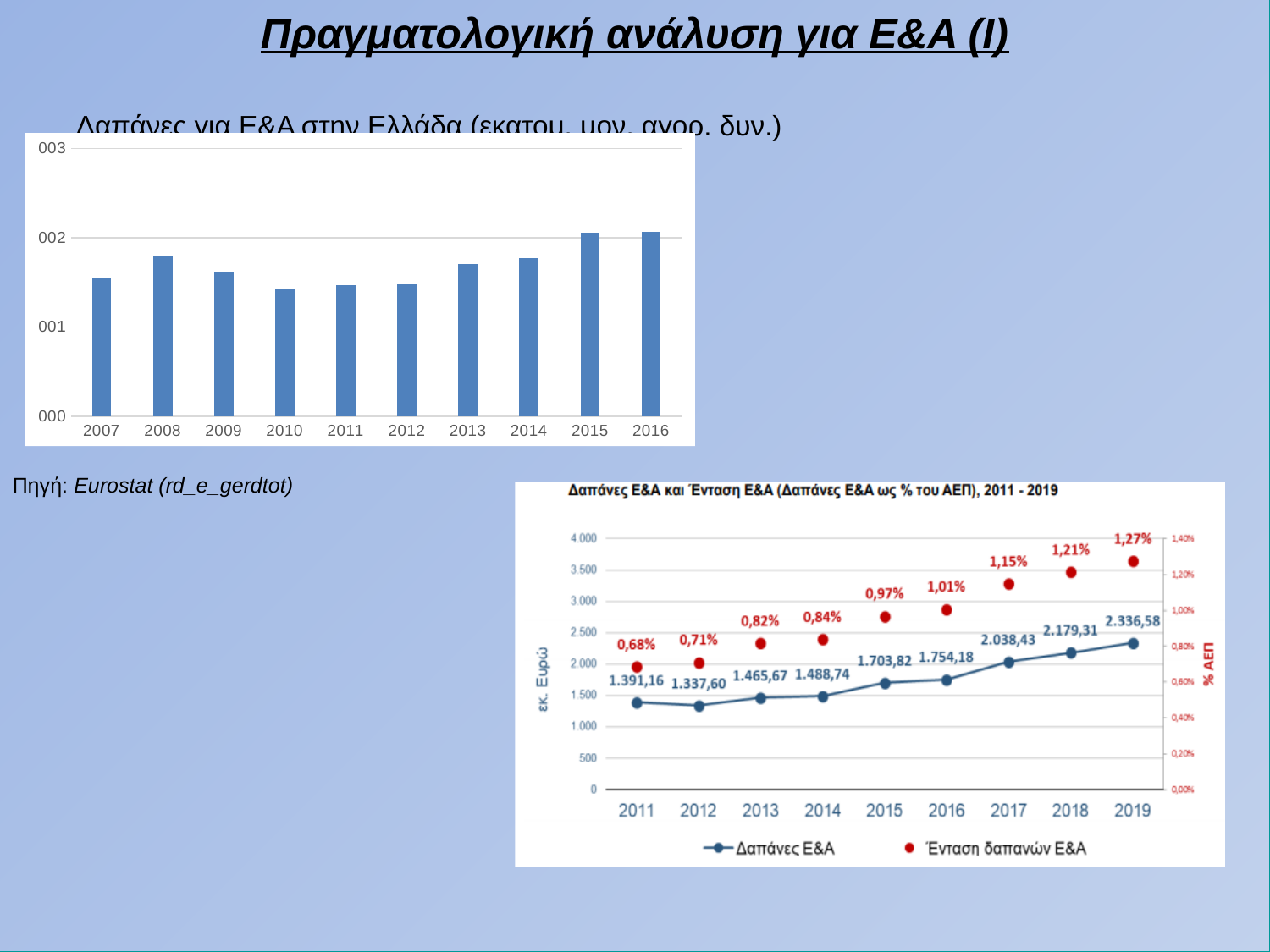
In the bottom-right chart, what is the Ένταση δαπανών Ε&Α value for 2011? 0,68% In the top-left bar chart, is the value for 2010 greater or less than 002? less In the bottom-right chart, which year has the highest Ένταση δαπανών Ε&Α value? 2019 What kind of chart is the top-left chart titled 'Δαπάνες για Ε&Α στην Ελλάδα'? bar chart In the bottom-right chart, which year has the lowest Δαπάνες Ε&Α value? 2012 In the top-left bar chart, how many years are shown on the x axis? 10 How many series does the legend of the bottom-right chart list? 2 In the top-left bar chart, which is larger, the value for 2008 or the value for 2010? 2008 In the bottom-right chart, what is the value of Δαπάνες Ε&Α for 2019? 2.336,58 In the bottom-right chart, what is the difference between the Δαπάνες Ε&Α values for 2019 and 2018? 157,27 In the top-left bar chart, is the value for 2015 greater or less than 002? greater In the bottom-right chart, does the Ένταση δαπανών Ε&Α series rise or fall from 2011 to 2019? rise